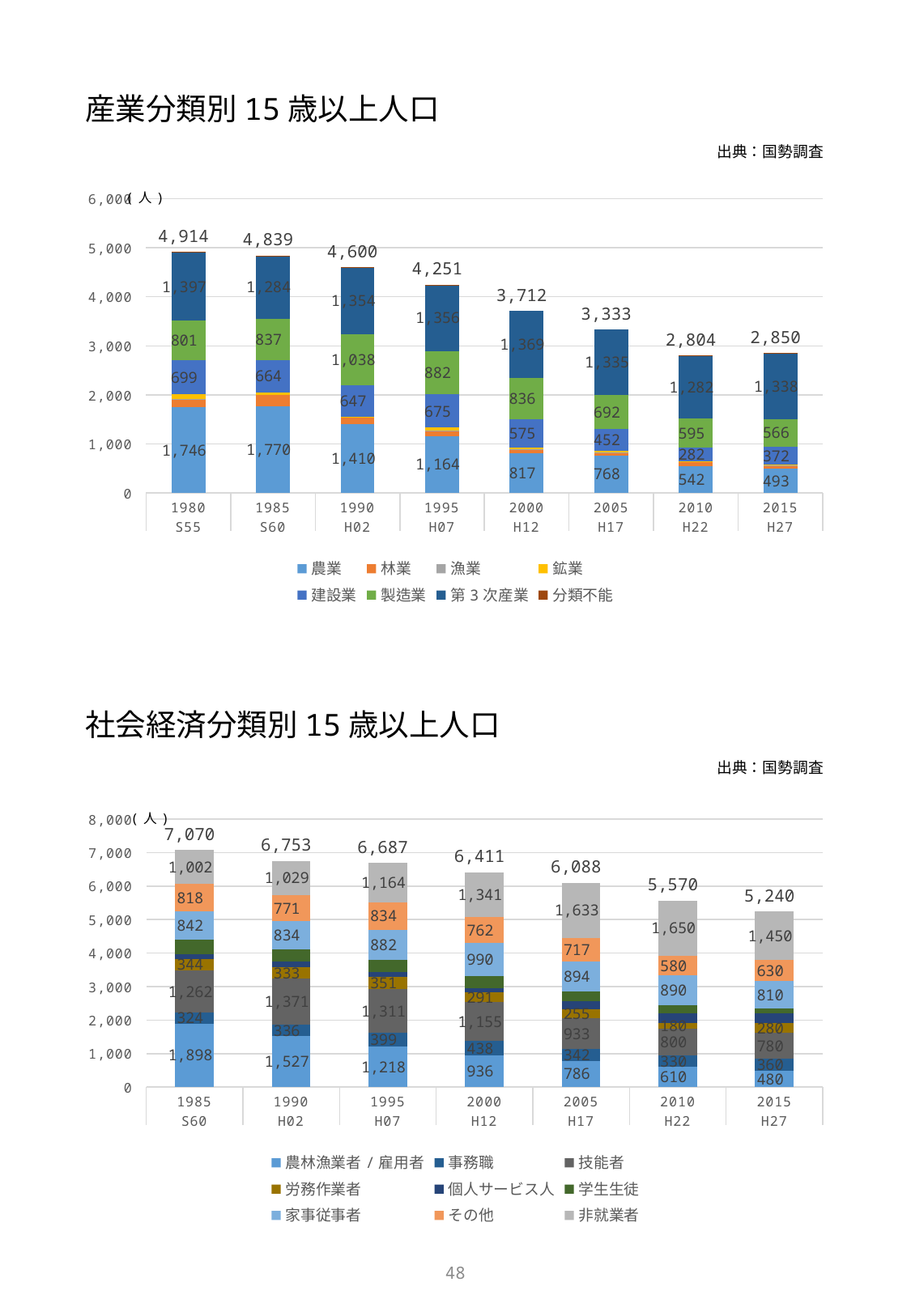
In the top chart (産業分類別 15 歳以上人口), how many years are shown on the x axis? 8 In the bottom chart (社会経済分類別 15 歳以上人口), what is the total for 2005 (H17)? 6,088 In the top chart (産業分類別 15 歳以上人口), what is the value for 第3次産業 in 2015 (H27)? 1,338 In the bottom chart (社会経済分類別 15 歳以上人口), what is the value for 非就業者 in 2010 (H22)? 1,650 In the top chart (産業分類別 15 歳以上人口), what is the value for 農業 in 1990 (H02)? 1,410 What kind of chart is the bottom chart (社会経済分類別 15 歳以上人口)? Stacked bar chart In the top chart (産業分類別 15 歳以上人口), what is the difference between the totals for 1980 and 2015? 2,064 In the top chart (産業分類別 15 歳以上人口), what is the total for 1980 (S55)? 4,914 In the top chart (産業分類別 15 歳以上人口), which year has the lowest total? 2010 (H22) In the bottom chart (社会経済分類別 15 歳以上人口), do the totals rise or fall from 1985 to 2015? Fall In the top chart (産業分類別 15 歳以上人口), how many series does the legend list? 8 In the bottom chart (社会経済分類別 15 歳以上人口), is the value for 農林漁業者／雇用者 larger in 1985 or in 2015? 1985